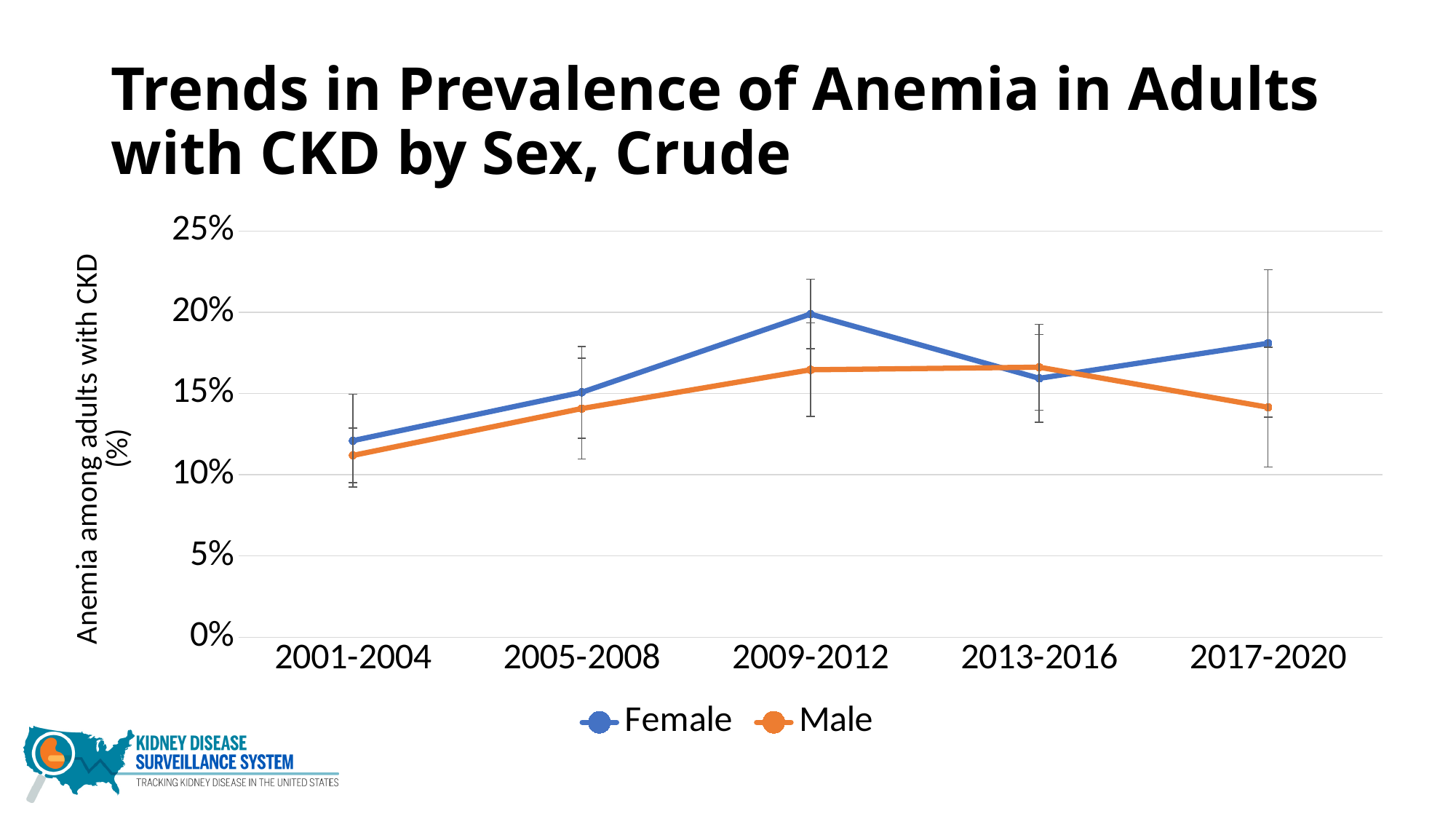
Is the Female value for 2009-2012 greater or less than 15%? greater In which period is the Female prevalence of anemia lowest? 2001-2004 In 2017-2020, which series has the higher prevalence, Female or Male? Female In 2009-2012, which series has the higher prevalence, Female or Male? Female Does the Male prevalence rise or fall from 2001-2004 to 2009-2012? rise What kind of chart is shown on the slide? line chart How many time periods are shown on the x axis? 5 What is the title of the chart's y axis? Anemia among adults with CKD (%) In which period is the Female prevalence of anemia highest? 2009-2012 How many series does the legend list? 2 In which period is the Male prevalence of anemia lowest? 2001-2004 Is the Male value for 2001-2004 greater or less than 15%? less